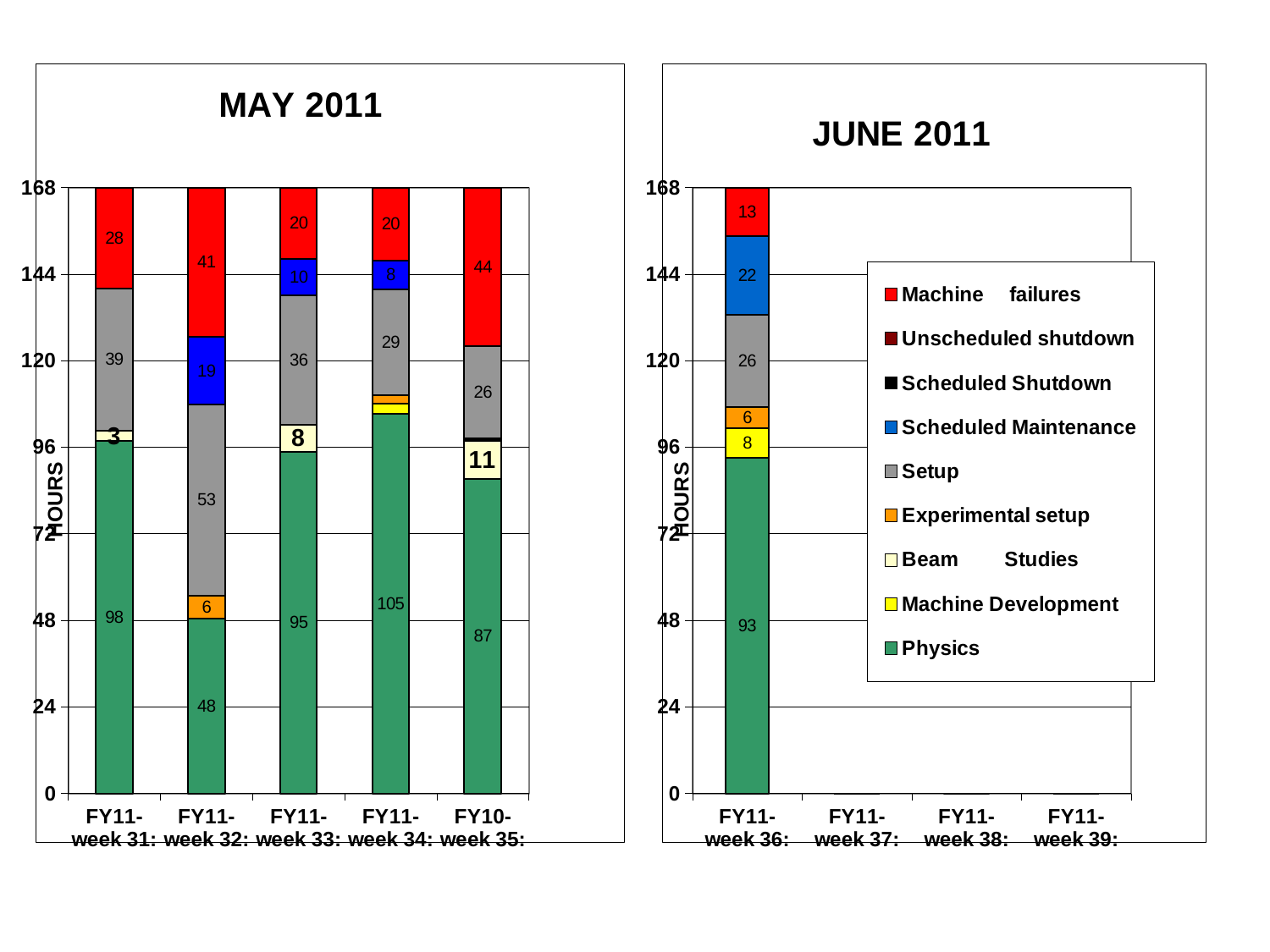
In the MAY 2011 chart, how many Physics hours are shown for FY11-week 34? 105 In the MAY 2011 chart, which week has the lowest Physics hours? FY11-week 32 In the MAY 2011 chart, how many Machine failures hours are shown for FY10-week 35? 44 What kind of chart is the MAY 2011 chart? Stacked bar chart In the MAY 2011 chart, which week has the highest Physics hours? FY11-week 34 In the MAY 2011 chart, how many Beam Studies hours are shown for FY10-week 35? 11 How many series does the legend on the JUNE 2011 chart list? 9 In the JUNE 2011 chart, what is the total number of hours in the FY11-week 36 stacked bar? 168 In the MAY 2011 chart, what is the difference in Physics hours between FY11-week 31 and FY11-week 32? 50 How many weeks are shown on the x axis of the MAY 2011 chart? 5 In the MAY 2011 chart, which week has more Setup hours, FY11-week 32 or FY11-week 33? FY11-week 32 In the JUNE 2011 chart, how many Scheduled Maintenance hours are shown for FY11-week 36? 22